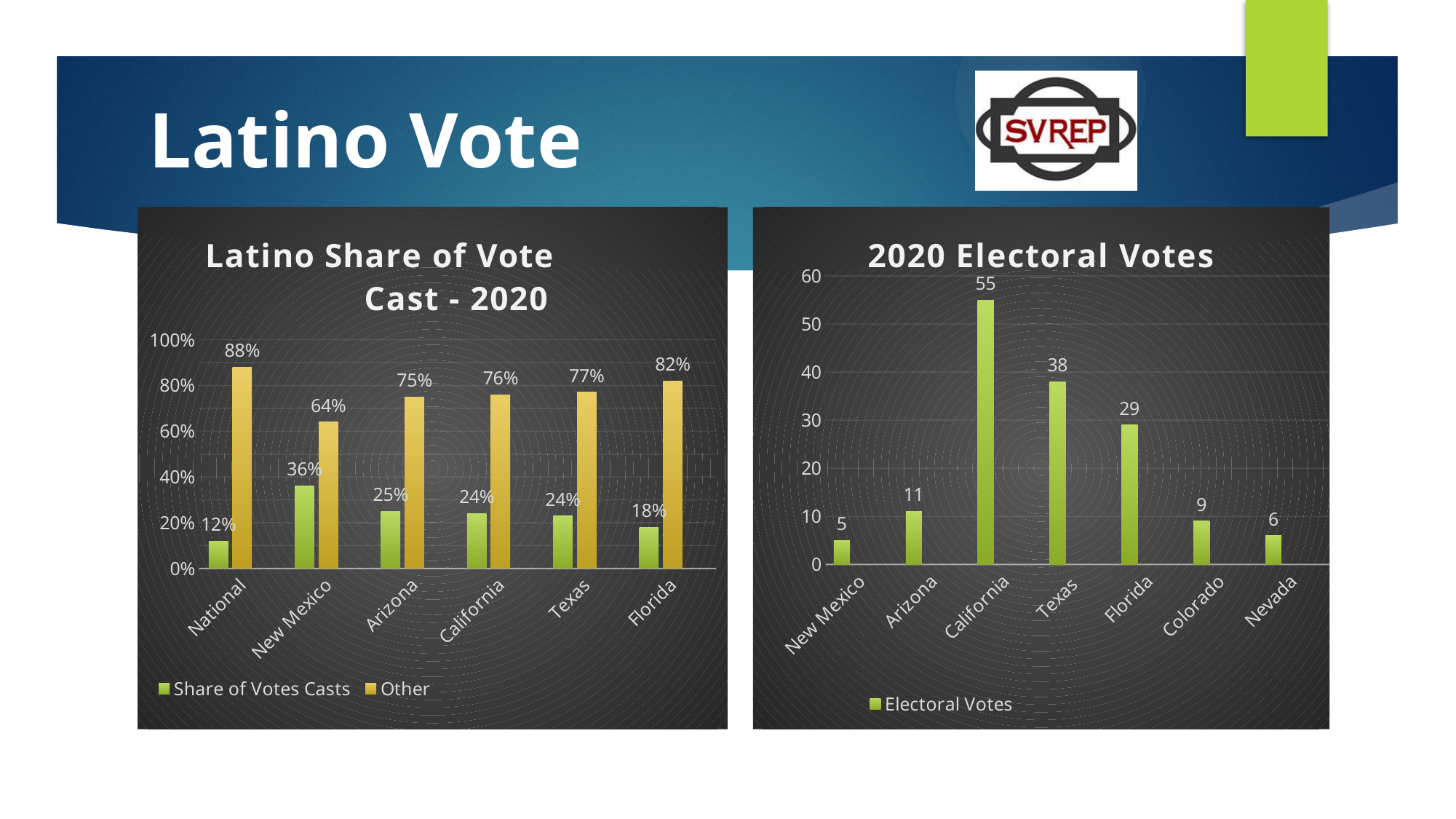
In the '2020 Electoral Votes' chart, what is the difference in electoral votes between California and Florida? 26 In the '2020 Electoral Votes' chart, which state has the fewest electoral votes? New Mexico In the '2020 Electoral Votes' chart, which state has the most electoral votes? California In the 'Latino Share of Vote Cast - 2020' chart, which category has the highest Share of Votes Casts? New Mexico In the 'Latino Share of Vote Cast - 2020' chart, how many categories are shown on the x axis? 6 In the 'Latino Share of Vote Cast - 2020' chart, how many series does the legend list? 2 In the 'Latino Share of Vote Cast - 2020' chart, what is the Share of Votes Casts value for New Mexico? 36% In the 'Latino Share of Vote Cast - 2020' chart, what is the Other value for Florida? 82% In the 'Latino Share of Vote Cast - 2020' chart, what is the difference between the Other value and the Share of Votes Casts value for Arizona? 50% What kind of chart is the '2020 Electoral Votes' chart? Bar chart In the 'Latino Share of Vote Cast - 2020' chart, which category has the lowest Share of Votes Casts? National In the '2020 Electoral Votes' chart, how many electoral votes does Texas have? 38